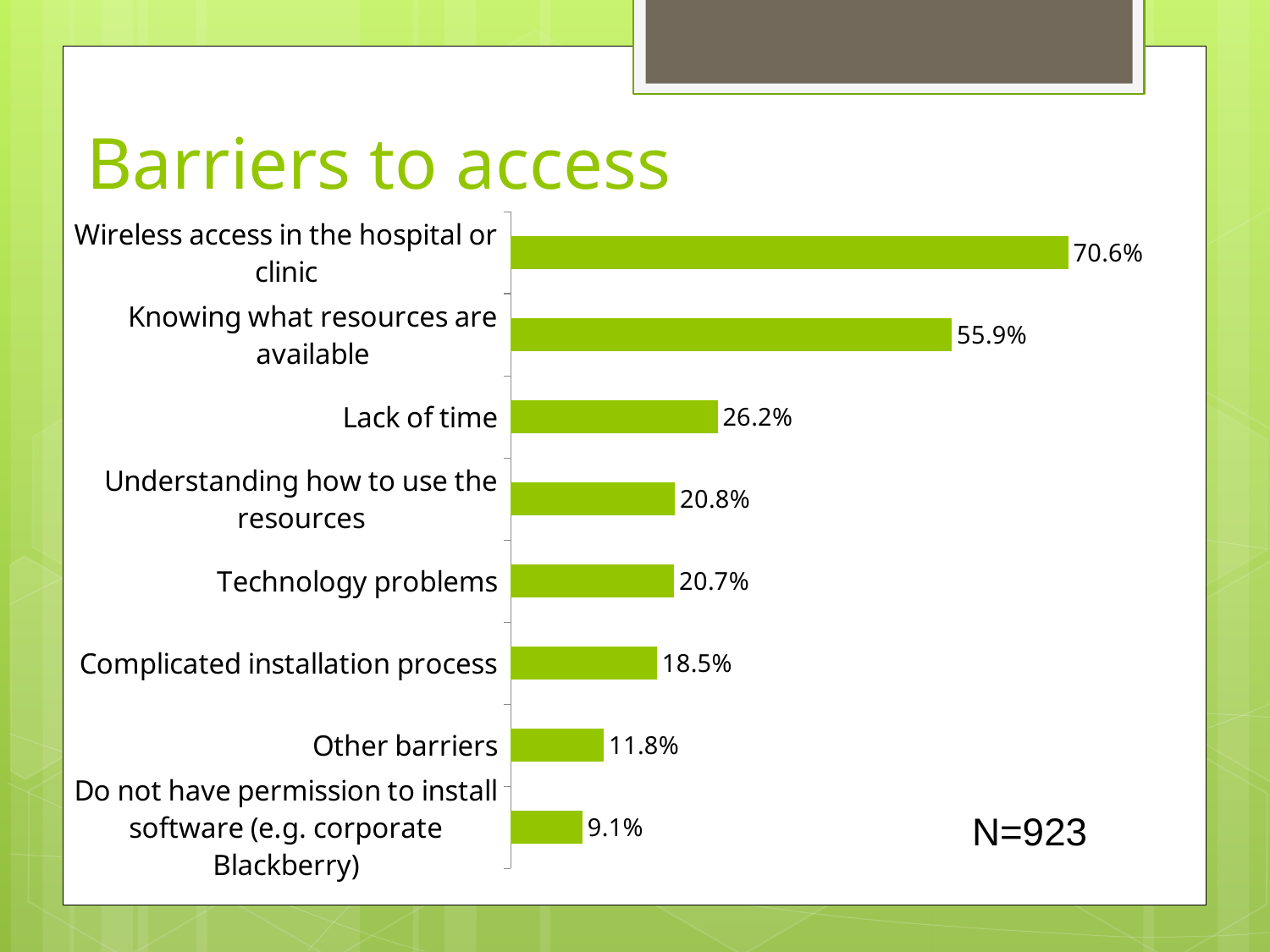
What percentage is shown for "Lack of time"? 26.2% What is the difference in percentage points between "Wireless access in the hospital or clinic" and "Knowing what resources are available"? 14.7 Which barrier has the lowest percentage? Do not have permission to install software (e.g. corporate Blackberry) How many barriers are listed in the chart? 8 What is the difference in percentage points between "Lack of time" and "Other barriers"? 14.4 What percentage is shown for "Other barriers"? 11.8% Which has a higher percentage, "Knowing what resources are available" or "Lack of time"? Knowing what resources are available What percentage is shown for "Wireless access in the hospital or clinic"? 70.6% What is the title of the slide containing the chart? Barriers to access Which barrier has the highest percentage? Wireless access in the hospital or clinic What kind of chart is shown on the slide? Bar chart What percentage is shown for "Complicated installation process"? 18.5%